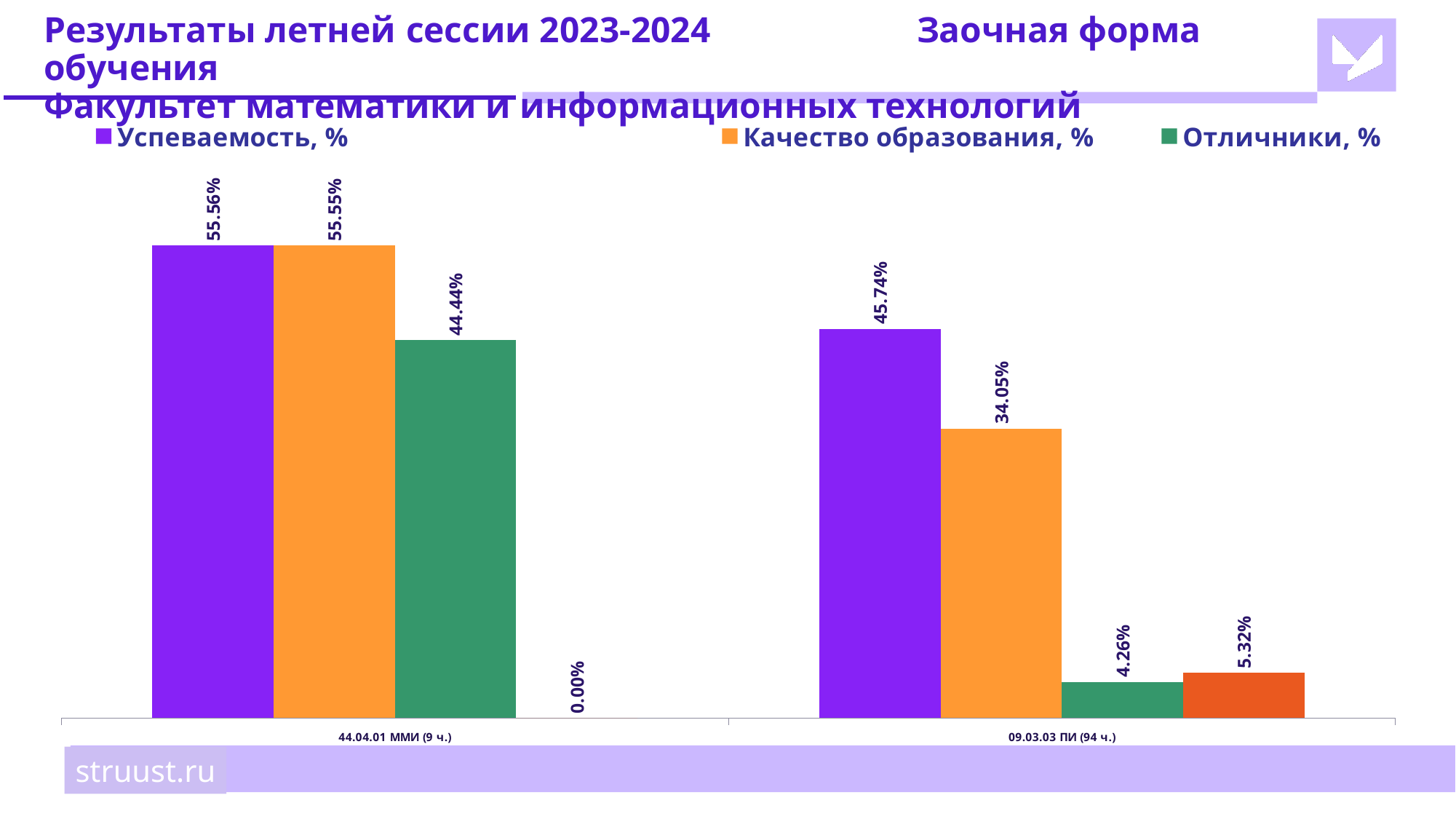
What is the value of Отличники, % for 09.03.03 ПИ (94 ч.)? 4.26% Which category has the highest value of Успеваемость, %? 44.04.01 ММИ (9 ч.) Which category has the higher value of Отличники, %: 44.04.01 ММИ (9 ч.) or 09.03.03 ПИ (94 ч.)? 44.04.01 ММИ (9 ч.) What is the value of Успеваемость, % for 44.04.01 ММИ (9 ч.)? 55.56% What is the value of Успеваемость, % for 09.03.03 ПИ (94 ч.)? 45.74% What type of chart is shown on the slide? Bar chart How many series does the chart legend list? 3 What is the value of Качество образования, % for 09.03.03 ПИ (94 ч.)? 34.05% What is the difference in Качество образования, % between 44.04.01 ММИ (9 ч.) and 09.03.03 ПИ (94 ч.)? 21.50% How many categories are shown on the x axis of the chart? 2 What is the value of Отличники, % for 44.04.01 ММИ (9 ч.)? 44.44% What is the difference in Успеваемость, % between 44.04.01 ММИ (9 ч.) and 09.03.03 ПИ (94 ч.)? 9.82%